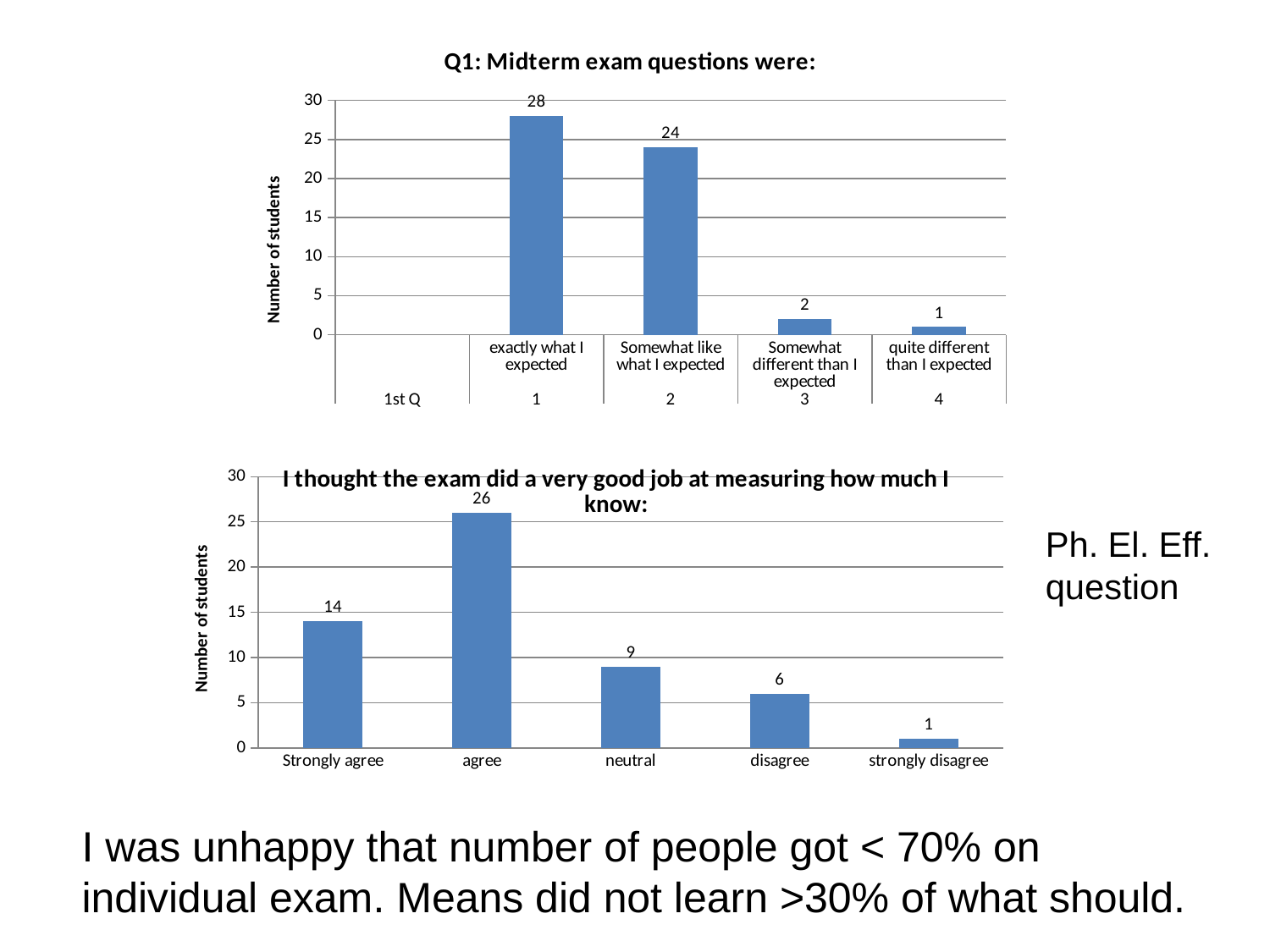
In the chart titled 'Q1: Midterm exam questions were:', how many students answered 'exactly what I expected'? 28 In the chart titled 'I thought the exam did a very good job at measuring how much I know:', how many students answered 'neutral'? 9 In the chart titled 'I thought the exam did a very good job at measuring how much I know:', which category has the lowest number of students? strongly disagree In the chart titled 'Q1: Midterm exam questions were:', what is the total number of students across all four categories? 55 In the chart titled 'Q1: Midterm exam questions were:', how many students answered 'quite different than I expected'? 1 In the chart titled 'Q1: Midterm exam questions were:', which category has the highest number of students? exactly what I expected In the chart titled 'Q1: Midterm exam questions were:', what kind of chart is shown? bar chart In the chart titled 'I thought the exam did a very good job at measuring how much I know:', what is the difference between 'agree' and 'Strongly agree'? 12 In the chart titled 'I thought the exam did a very good job at measuring how much I know:', how many categories are shown on the x axis? 5 In the chart titled 'I thought the exam did a very good job at measuring how much I know:', which is larger, 'Strongly agree' or 'disagree'? Strongly agree In the chart titled 'I thought the exam did a very good job at measuring how much I know:', how many students answered 'agree'? 26 In the chart titled 'Q1: Midterm exam questions were:', what is the difference between 'exactly what I expected' and 'Somewhat like what I expected'? 4